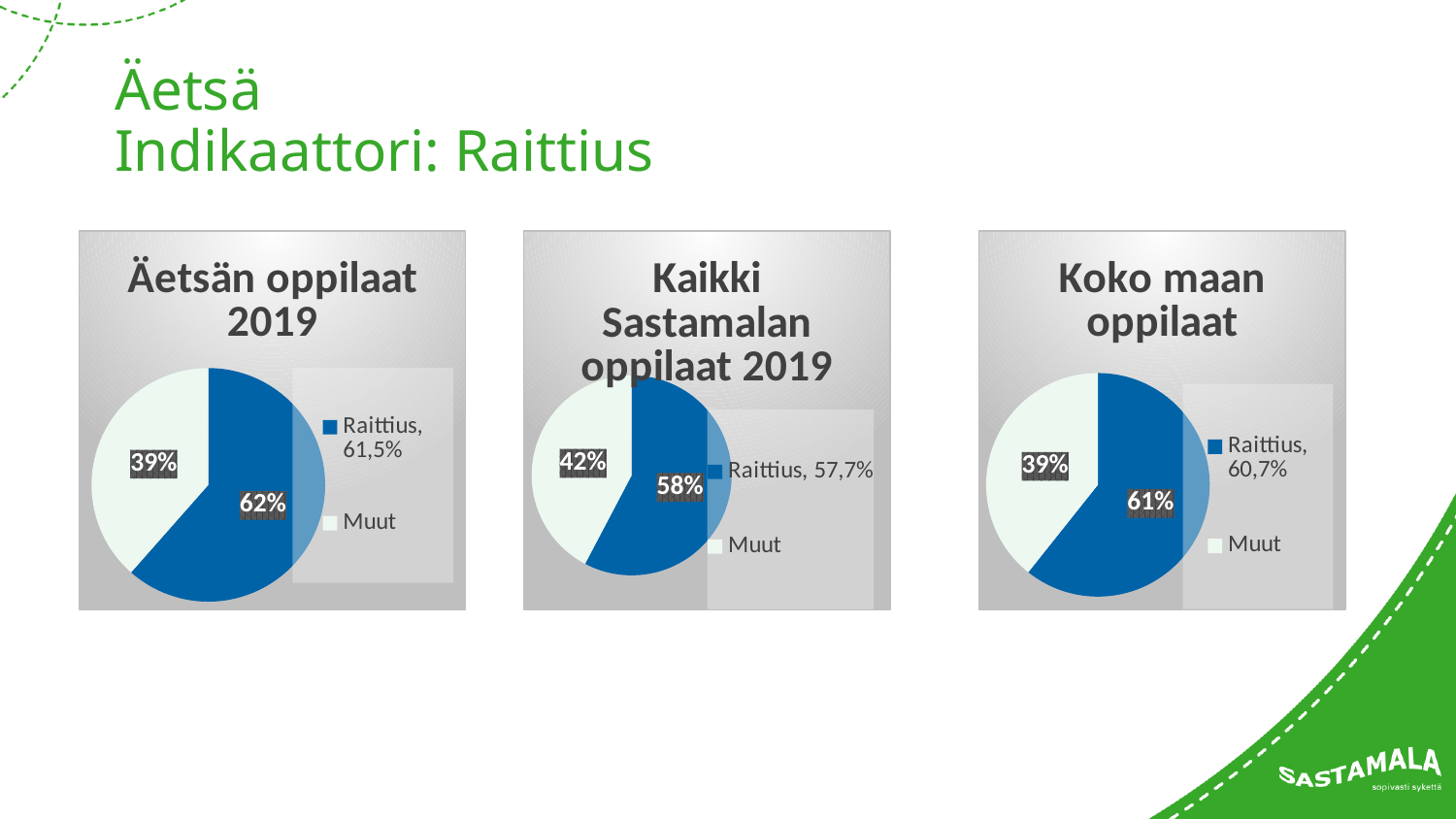
In the chart titled "Kaikki Sastamalan oppilaat 2019", which slice is larger, Raittius or Muut? Raittius In the chart titled "Äetsän oppilaat 2019", what percentage is shown on the Muut slice? 39% In the chart titled "Koko maan oppilaat", what value for Raittius is given in the legend? 60,7% In the chart titled "Kaikki Sastamalan oppilaat 2019", what value for Raittius is given in the legend? 57,7% In the chart titled "Kaikki Sastamalan oppilaat 2019", what percentage is shown on the Raittius slice? 58% In the chart titled "Äetsän oppilaat 2019", what percentage is shown on the Raittius slice? 62% What kind of chart is the chart titled "Koko maan oppilaat"? Pie chart How many slices does the chart titled "Äetsän oppilaat 2019" have? 2 In the chart titled "Äetsän oppilaat 2019", what value for Raittius is given in the legend? 61,5%